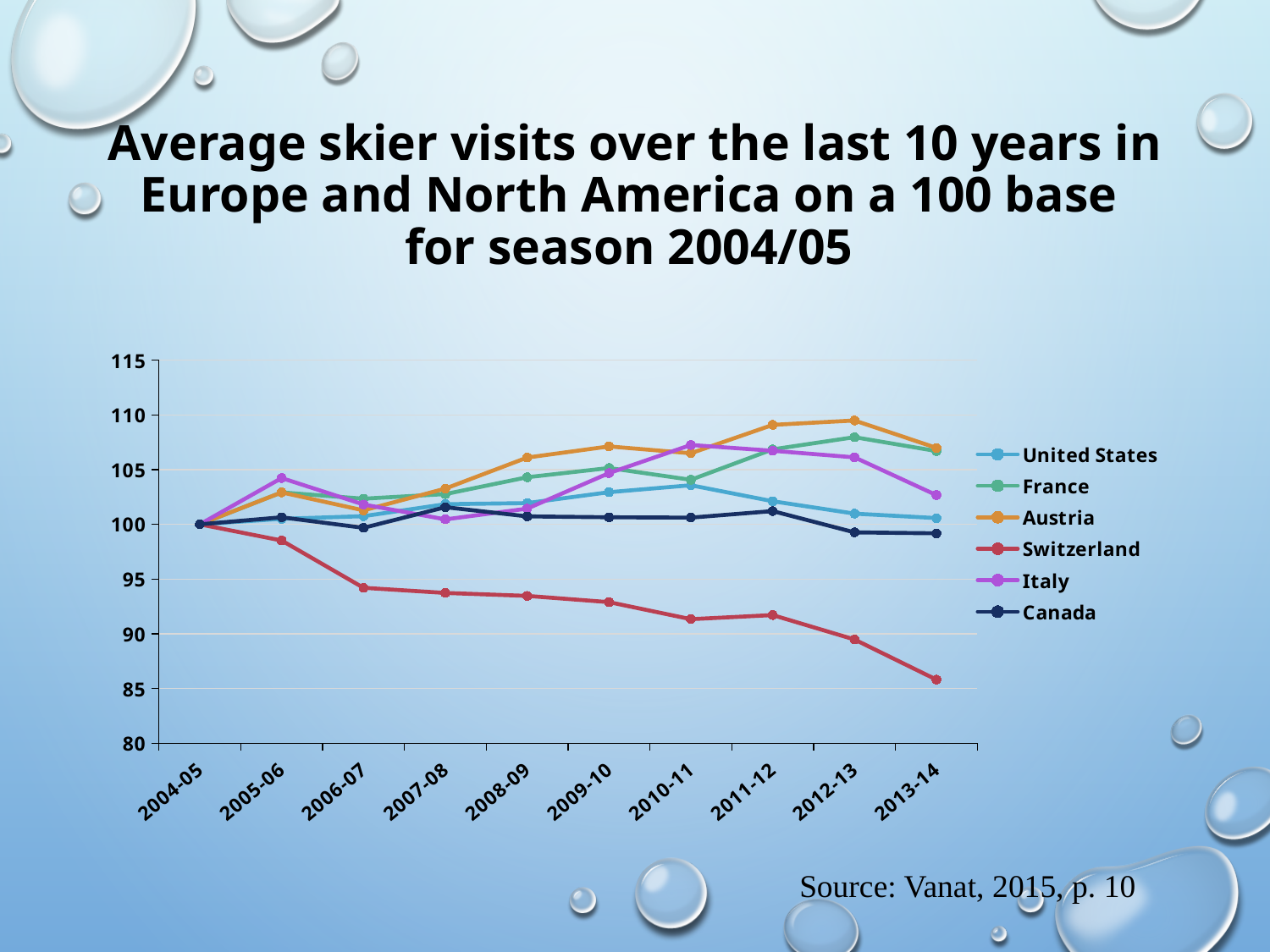
How many series does the legend list? 6 What colour is the Switzerland line in the chart? red Which country has the highest value in 2012-13? Austria Which is larger in 2005-06, the value for Italy or the value for the United States? Italy What kind of chart is shown on the slide? line chart How many seasons are shown along the x axis? 10 Is the value for Austria in 2012-13 greater or less than 105? greater Does the Switzerland line rise or fall from 2004-05 to 2013-14? fall Which is larger in 2011-12, the value for Austria or the value for Canada? Austria Is the value for Switzerland in 2013-14 greater or less than 90? less What is the value for Switzerland in 2004-05? 100 Which country has the lowest value in 2013-14? Switzerland